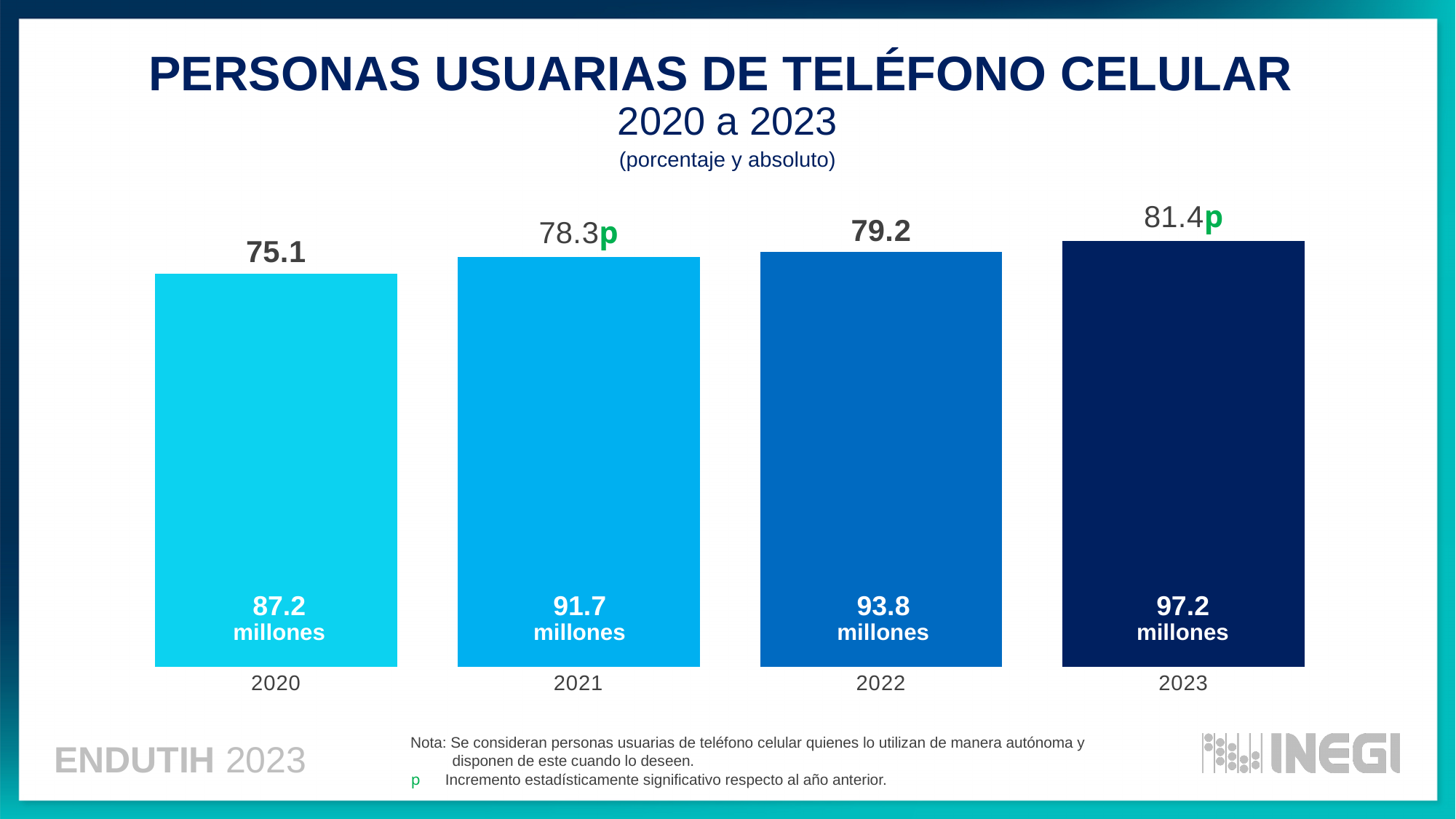
Do the percentages of cell phone users rise or fall from 2020 to 2023? Rise By how many millions did the number of cell phone users grow from 2020 to 2023? 10.0 millones How many millions of cell phone users are shown inside the bar for 2021? 91.7 millones What type of chart is shown on the slide? Bar chart Which year has the lowest number of cell phone users in millions? 2020 What percentage of people were cell phone users in 2020? 75.1 Which year has a higher percentage of cell phone users, 2021 or 2022? 2022 How many years (bars) are shown in the chart? 4 What percentage is shown above the bar for 2023? 81.4 How many millions of cell phone users are shown for 2022? 93.8 millones Which year has the highest percentage of cell phone users? 2023 What is the difference in percentage points between 2023 and 2020? 6.3